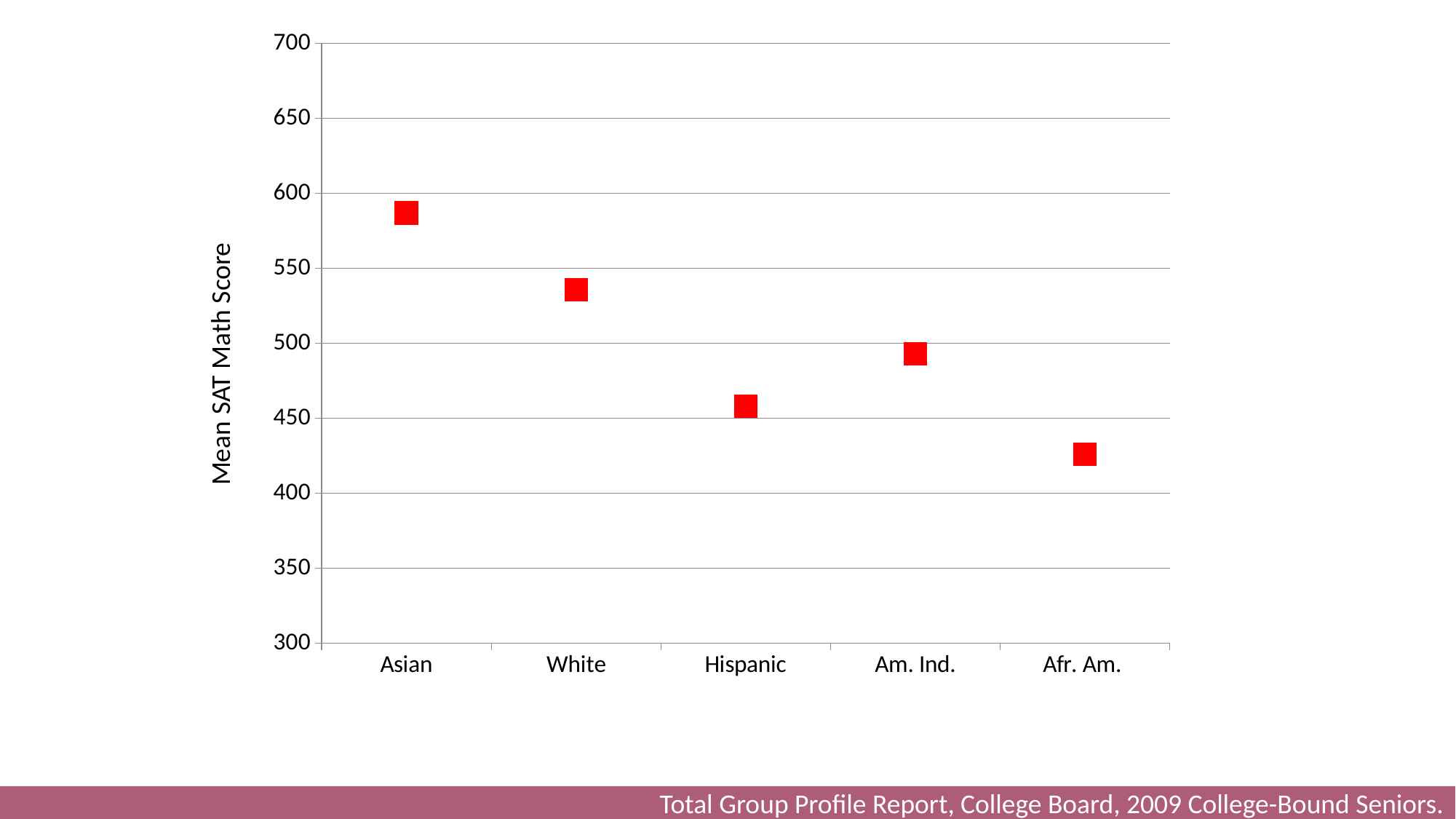
How many categories are plotted on the chart? 5 What kind of chart is shown on the slide? scatter chart Which has a higher mean SAT math score, Hispanic or Am. Ind.? Am. Ind. Is the mean SAT math score for Am. Ind. greater or less than 450? greater What is the label of the vertical axis? Mean SAT Math Score Which category has the lowest mean SAT math score? Afr. Am. Is the mean SAT math score for Afr. Am. greater or less than 450? less Which category has the highest mean SAT math score? Asian Which has a higher mean SAT math score, White or Afr. Am.? White Is the mean SAT math score for Asian greater or less than 550? greater